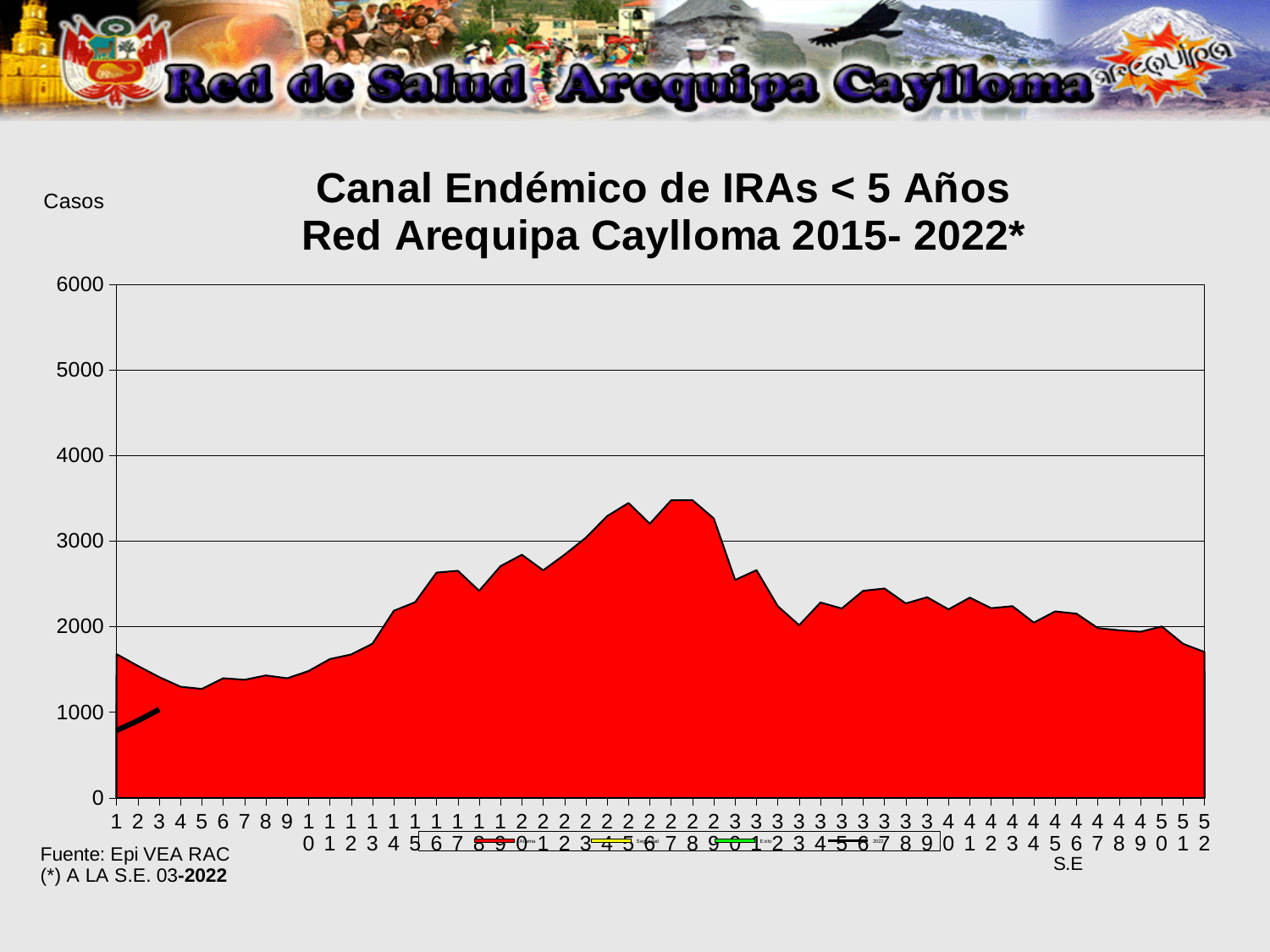
What label is shown on the vertical axis of the chart? Casos What is the highest value shown on the y axis? 6000 Around which week does the red area reach its highest value? Week 28 Is the value of the red area at week 40 greater or less than 2000? greater How many epidemiological weeks (S.E) are shown along the x axis? 52 Is the value of the red area at week 28 greater or less than 3000? greater Is the value of the red area at week 5 greater or less than 2000? less What is the title of the chart? Canal Endémico de IRAs < 5 Años Red Arequipa Caylloma 2015- 2022* What kind of chart is shown on the slide? Combination area and line chart Which has a larger value in the red area, week 10 or week 40? Week 40 Do the values of the red area rise or fall from week 28 to week 52? Fall